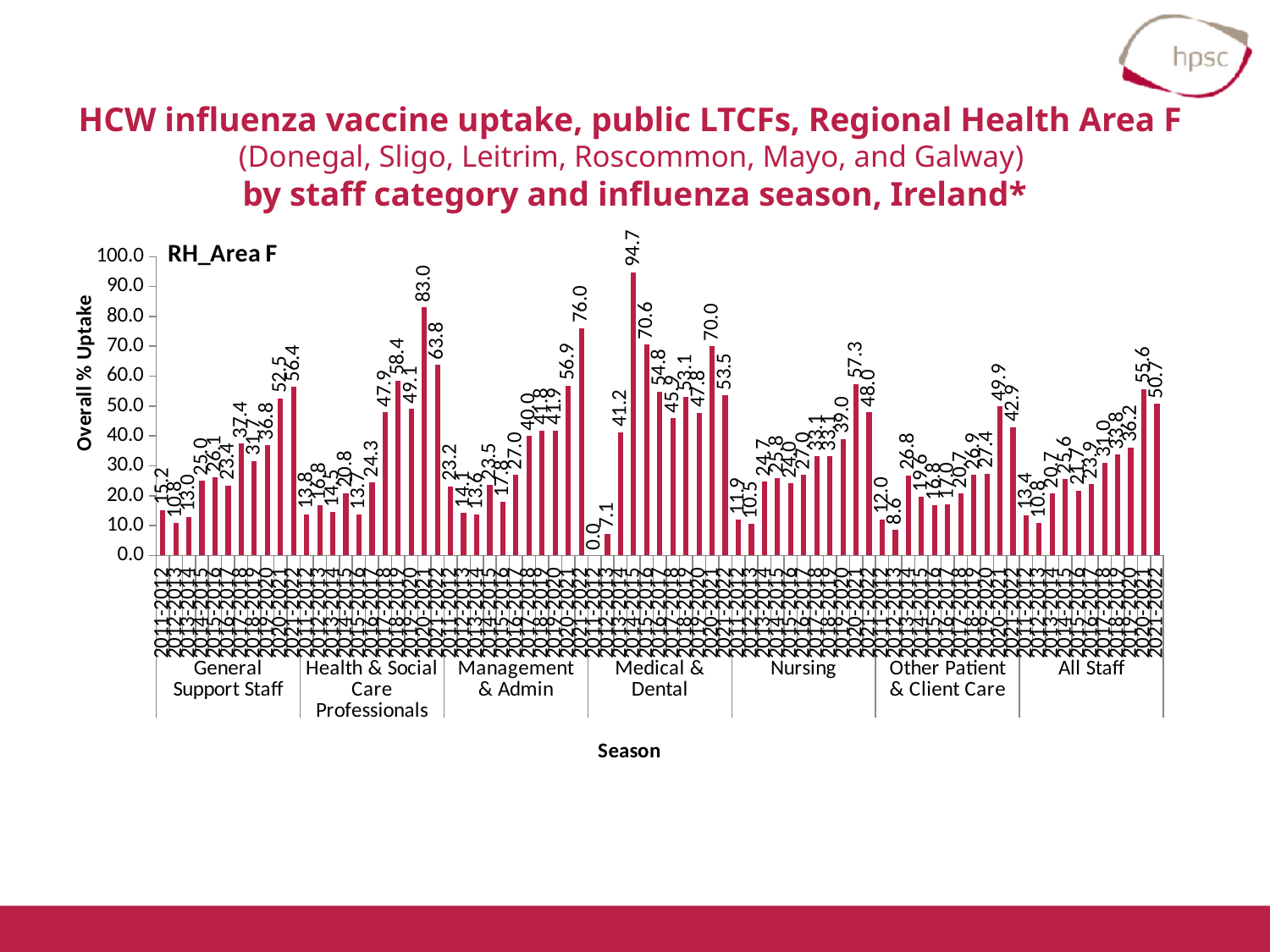
What is the value for All Staff in the 2021-2022 season? 50.7 What is the highest value shown for Health & Social Care Professionals? 83.0 What is the label on the y axis of the chart? Overall % Uptake What is the highest value shown for All Staff? 55.6 Which staff category contains the highest bar in the chart, and what is its value? Medical & Dental, 94.7 What is the highest value shown for Management & Admin? 76.0 Do the All Staff values generally rise or fall from the 2011-2012 season to the 2020-2021 season? rise Which is larger: the highest Nursing value or the highest General Support Staff value? Nursing (57.3) What is the difference between the highest Medical & Dental value (94.7) and the highest Health & Social Care Professionals value (83.0)? 11.7 How many staff categories are shown along the x axis of the chart? 7 What kind of chart is shown on the slide? bar chart What is the lowest value plotted in the chart, and in which staff category does it occur? 0.0, Medical & Dental